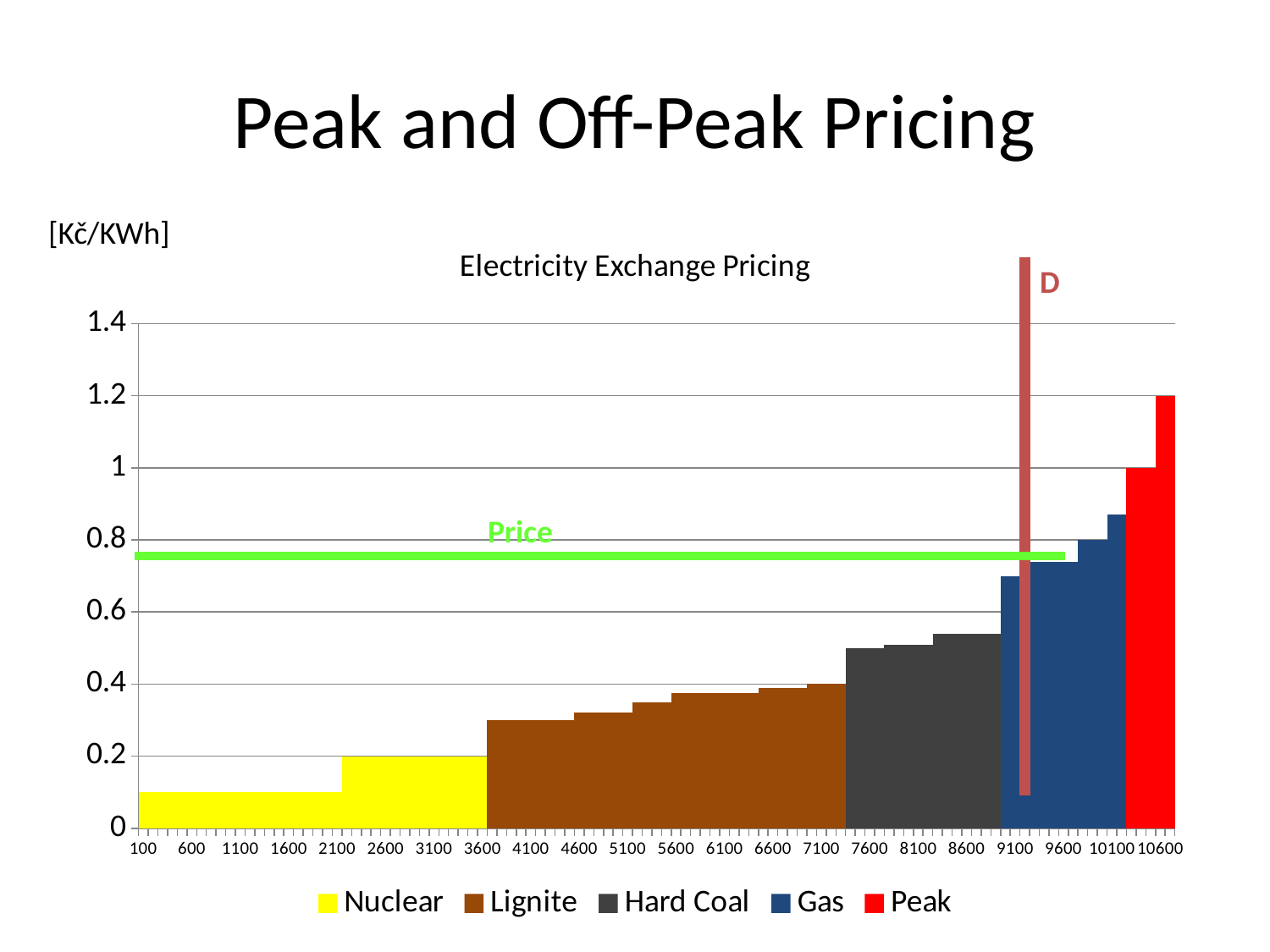
What kind of chart is shown on the slide? bar chart What are the series listed in the legend of the chart? Nuclear, Lignite, Hard Coal, Gas, Peak Do the bar values rise or fall from left to right along the x axis? rise Are the Nuclear bars greater or less than 0.4? less Which series has the highest bars in the chart? Peak Which series has larger values, Gas or Lignite? Gas What is the value of the tallest Peak bar? 1.2 How many series does the legend of the Electricity Exchange Pricing chart list? 5 Is the tallest Gas bar greater or less than 0.8? greater Are the Hard Coal bars greater or less than 0.6? less What is the title of the chart? Electricity Exchange Pricing Which series has the lowest bars in the chart? Nuclear